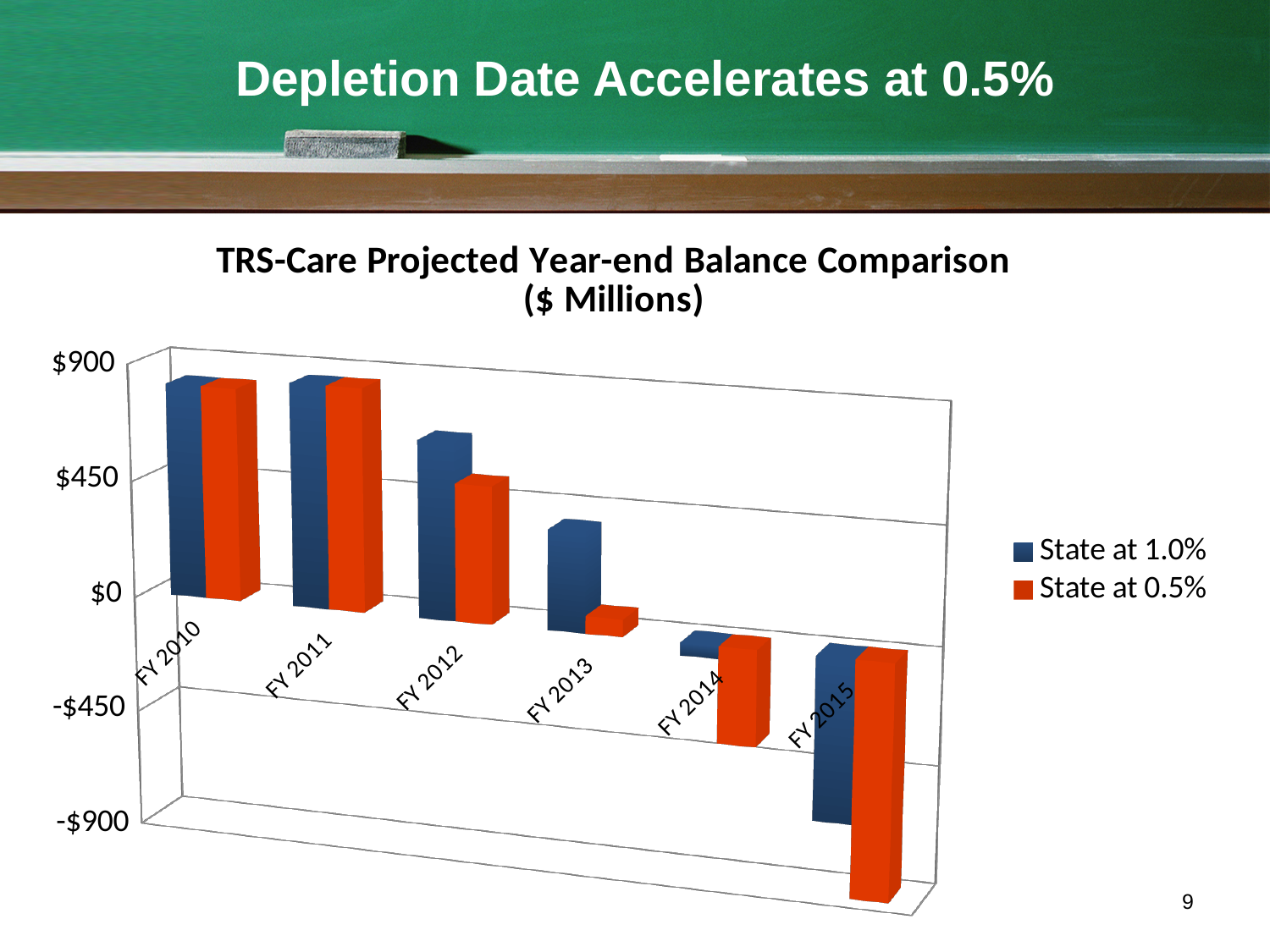
How many fiscal years are shown on the x axis of the chart? 6 Is the value for State at 1.0% in FY 2013 greater or less than $0? greater What is the title of the chart? TRS-Care Projected Year-end Balance Comparison ($ Millions) What kind of chart is shown on the slide? Bar chart Which fiscal year has the lowest value for State at 0.5%? FY 2015 Which series is shown in orange in the chart? State at 0.5% Do the values for State at 0.5% rise or fall from FY 2010 to FY 2015? Fall How many series does the chart's legend list? 2 Is the value for State at 1.0% in FY 2010 greater or less than $450? greater Is the value for State at 0.5% in FY 2015 greater or less than -$450? less In FY 2012, which series has the larger value, State at 1.0% or State at 0.5%? State at 1.0%